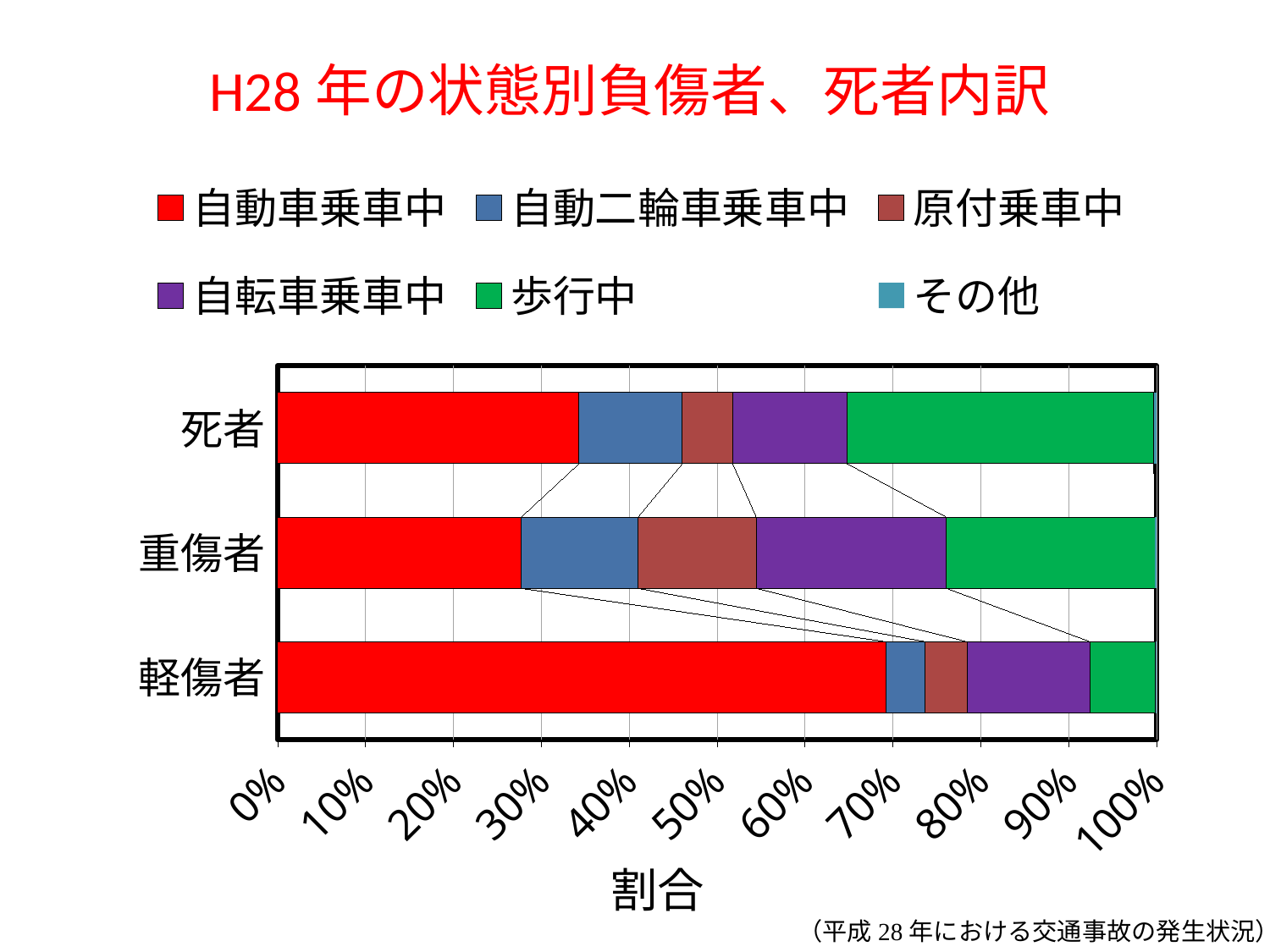
What is the label of the horizontal axis? 割合 Which has the larger 自転車乗車中 share, 重傷者 or 軽傷者? 重傷者 Is the 自動車乗車中 share for 軽傷者 greater or less than 60%? greater Which category has the largest 自動車乗車中 share? 軽傷者 Is the 歩行中 share for 死者 greater or less than 30%? greater What kind of chart is shown on the slide? Stacked bar chart How many series does the chart's legend list? 6 What is the title of the chart on the slide? H28年の状態別負傷者、死者内訳 Is the 自動車乗車中 share for 死者 greater or less than 40%? less How many categories are plotted on the vertical axis of the chart? 3 Which category has the largest 歩行中 share? 死者